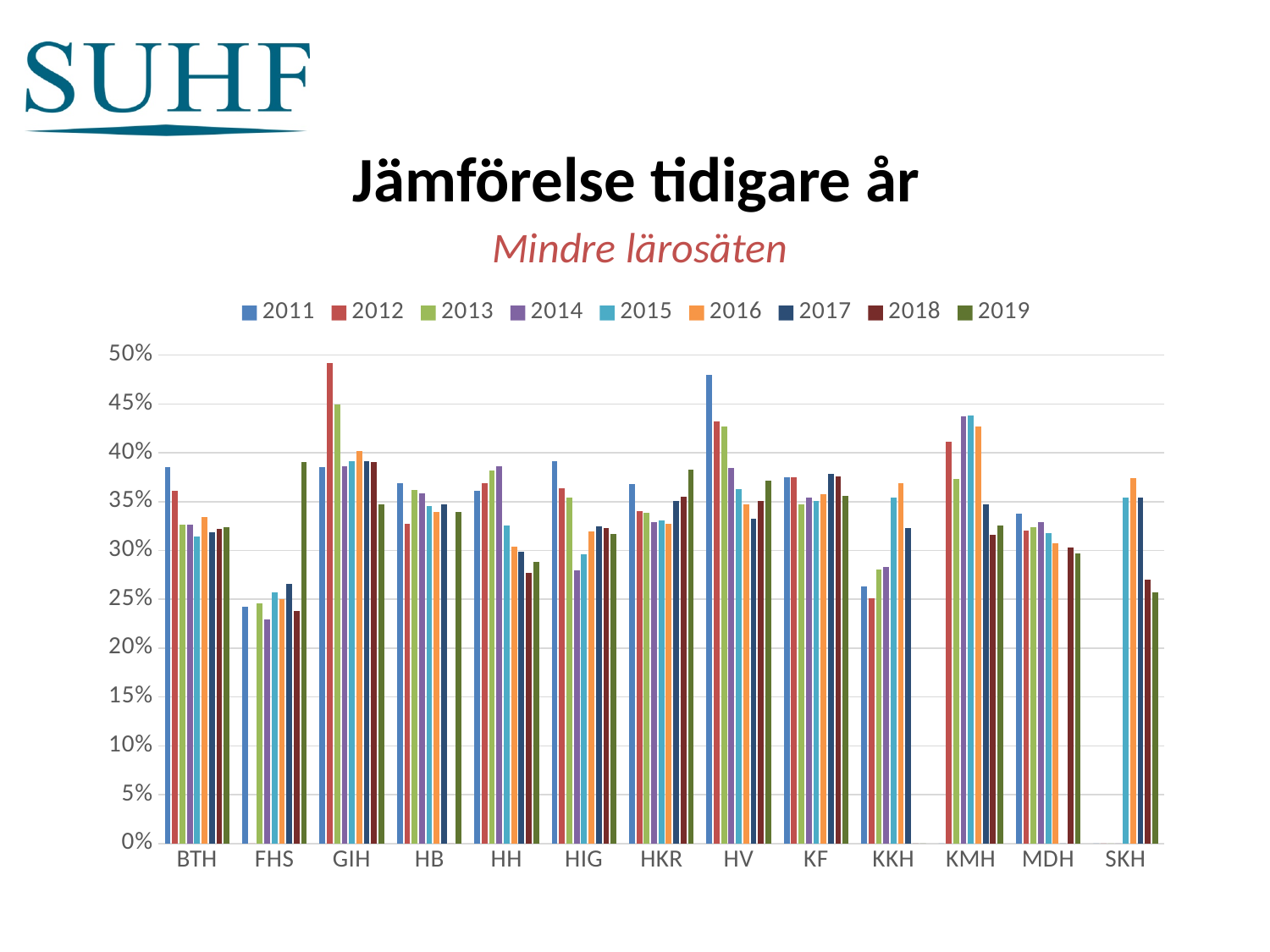
How many series (years) does the legend list? 9 Is the 2011 value for FHS greater or less than 25%? less What kind of chart is shown on the slide? bar chart How many institutions (categories) are shown along the x axis? 13 Which is larger, the 2012 value for GIH or the 2012 value for HB? GIH Is the 2012 value for GIH greater or less than 45%? greater Which year has the highest value for GIH? 2012 What is the title of the chart? Jämförelse tidigare år Which year has the highest value for HV? 2011 Is the 2019 value for SKH greater or less than 30%? less Which year has the highest value for FHS? 2019